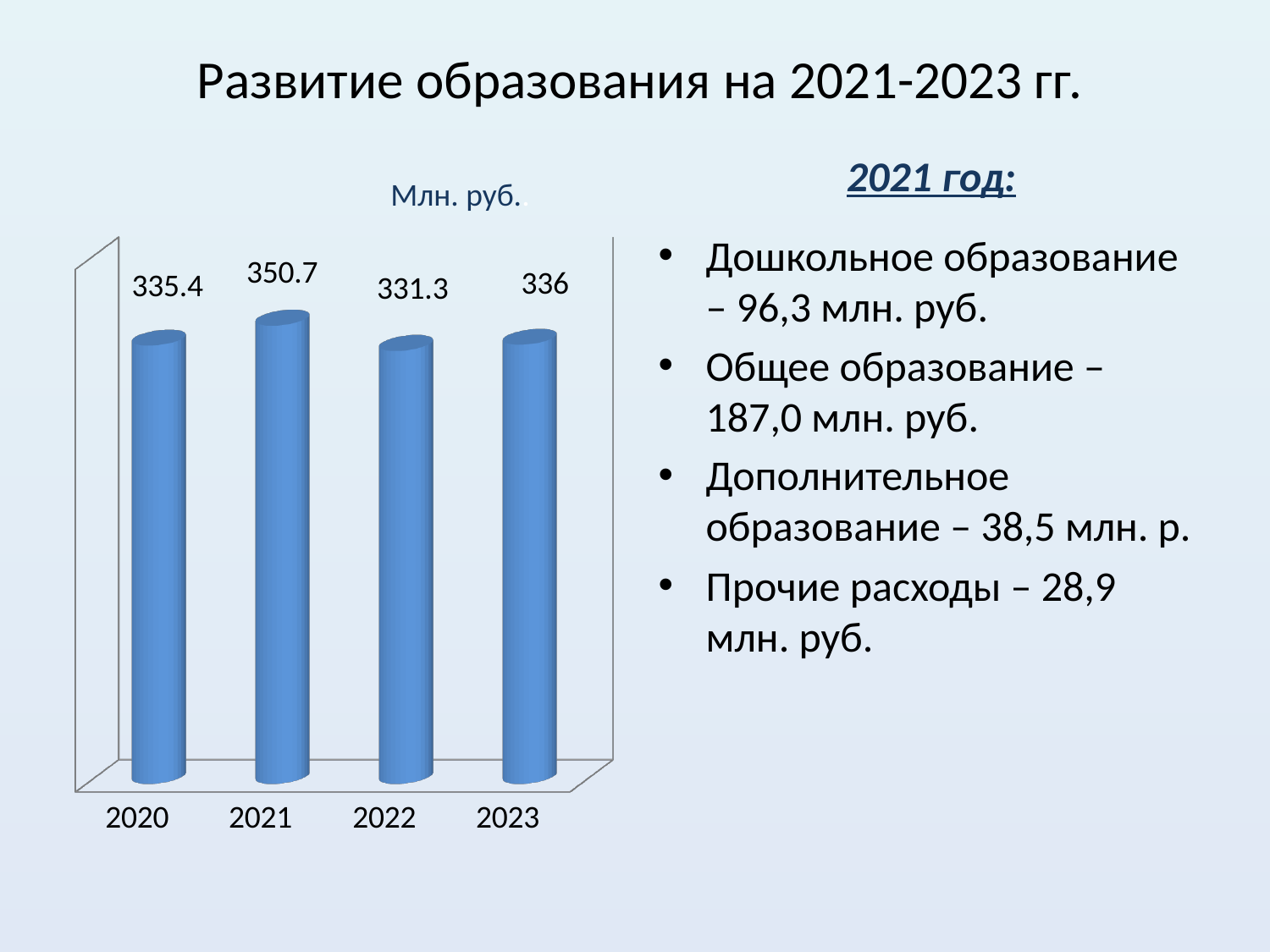
How many years are shown on the chart? 4 Which is larger, the value for 2020 or the value for 2021? 2021 What is the value for 2022? 331.3 Which year has the highest value? 2021 What is the value for 2023? 336 What is the value for 2020? 335.4 What is the difference between the values for 2021 and 2022? 19.4 What is the title of the chart? Млн. руб. Which year has the lowest value? 2022 What is the difference between the values for 2023 and 2020? 0.6 What is the value for 2021? 350.7 What kind of chart is shown on the slide? bar chart